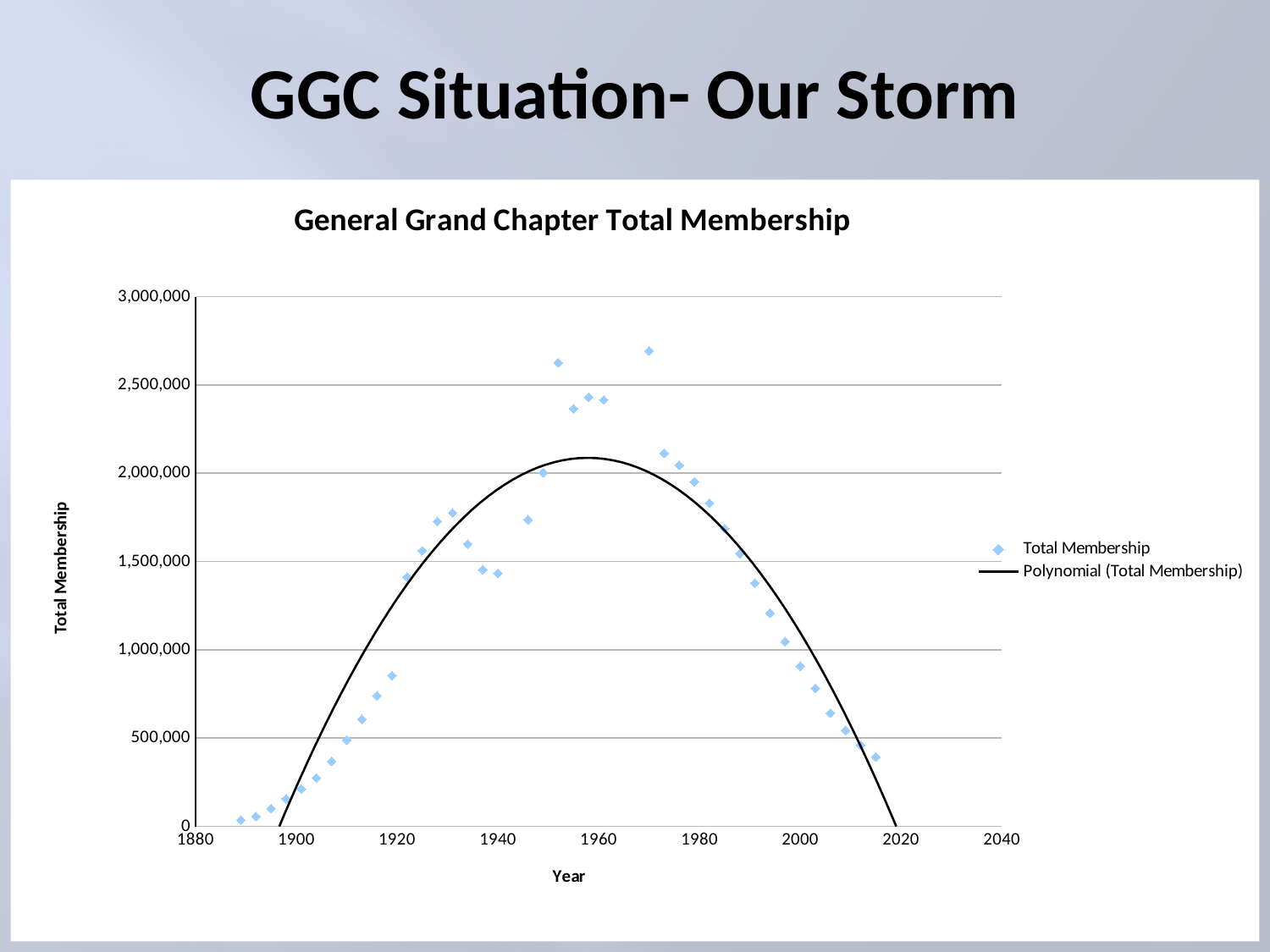
How many entries does the chart legend list? 2 Do the Total Membership values rise or fall between 1970 and 2015? fall Do the Total Membership values rise or fall between 1890 and 1930? rise Is the Total Membership value plotted at 2000 greater or less than 1,000,000? less Is the Total Membership value plotted at 2015 greater or less than 500,000? less Is the Total Membership value plotted at 1990 greater or less than 1,000,000? greater What is the label on the x axis of the chart? Year Which is larger, the Total Membership value plotted at 1960 or the value plotted at 2000? 1960 What kind of chart is shown on the slide? Scatter chart What is the title of the chart? General Grand Chapter Total Membership